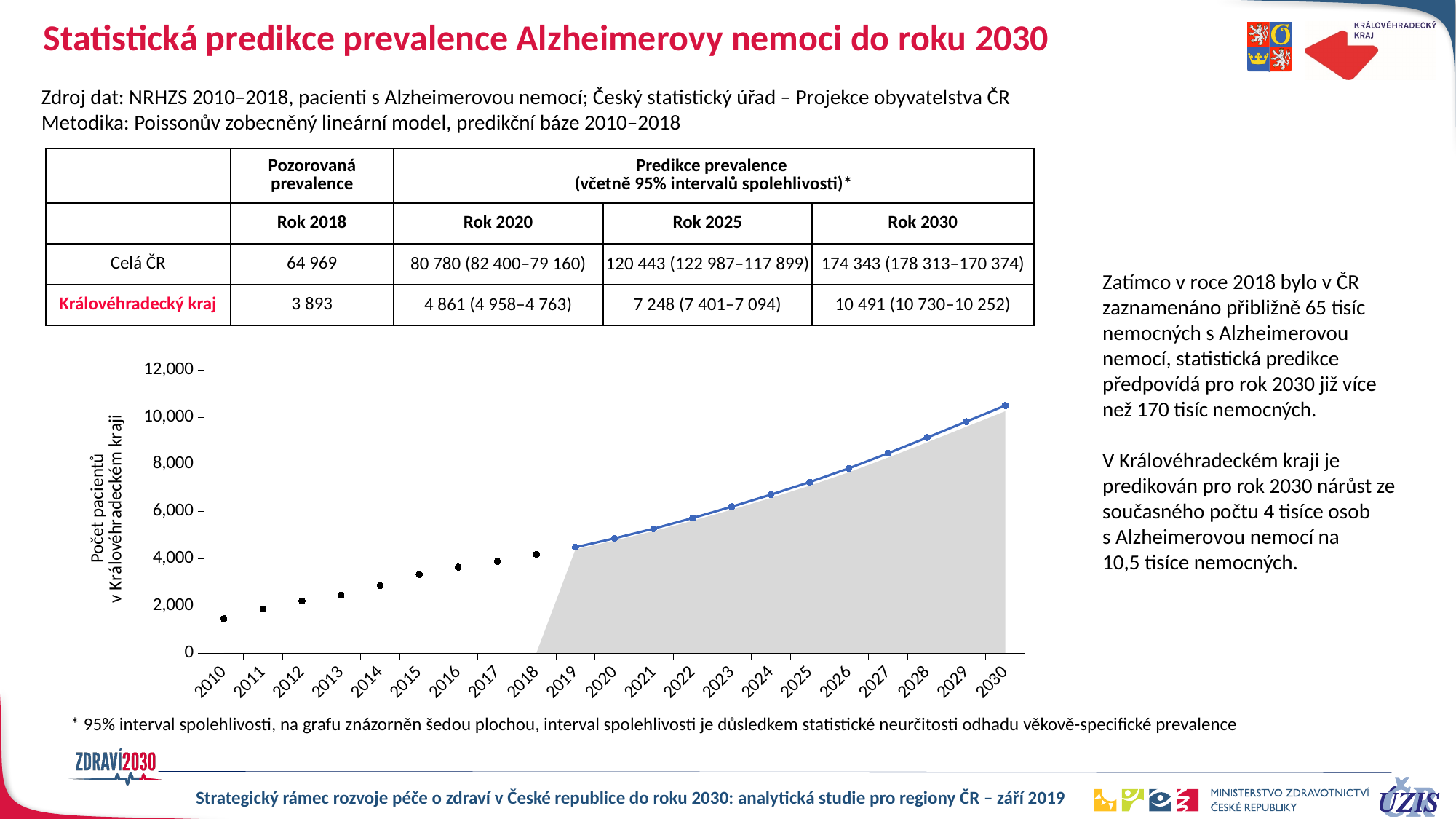
Is the value for 2030 larger than the value for 2020? Yes Is the value for 2025 greater or less than 6,000? greater What kind of chart is shown on the slide? line chart Which year has the highest value in the chart? 2030 What is the label of the y axis of the chart? Počet pacientů v Královéhradeckém kraji Is the value for 2030 greater or less than 10,000? greater Is the value for 2015 greater or less than 4,000? less How many years are shown on the x axis of the chart? 21 What does the grey area in the chart represent, according to the footnote? 95% interval spolehlivosti Which year has the lowest value in the chart? 2010 Do the values in the chart rise or fall from 2010 to 2030? rise